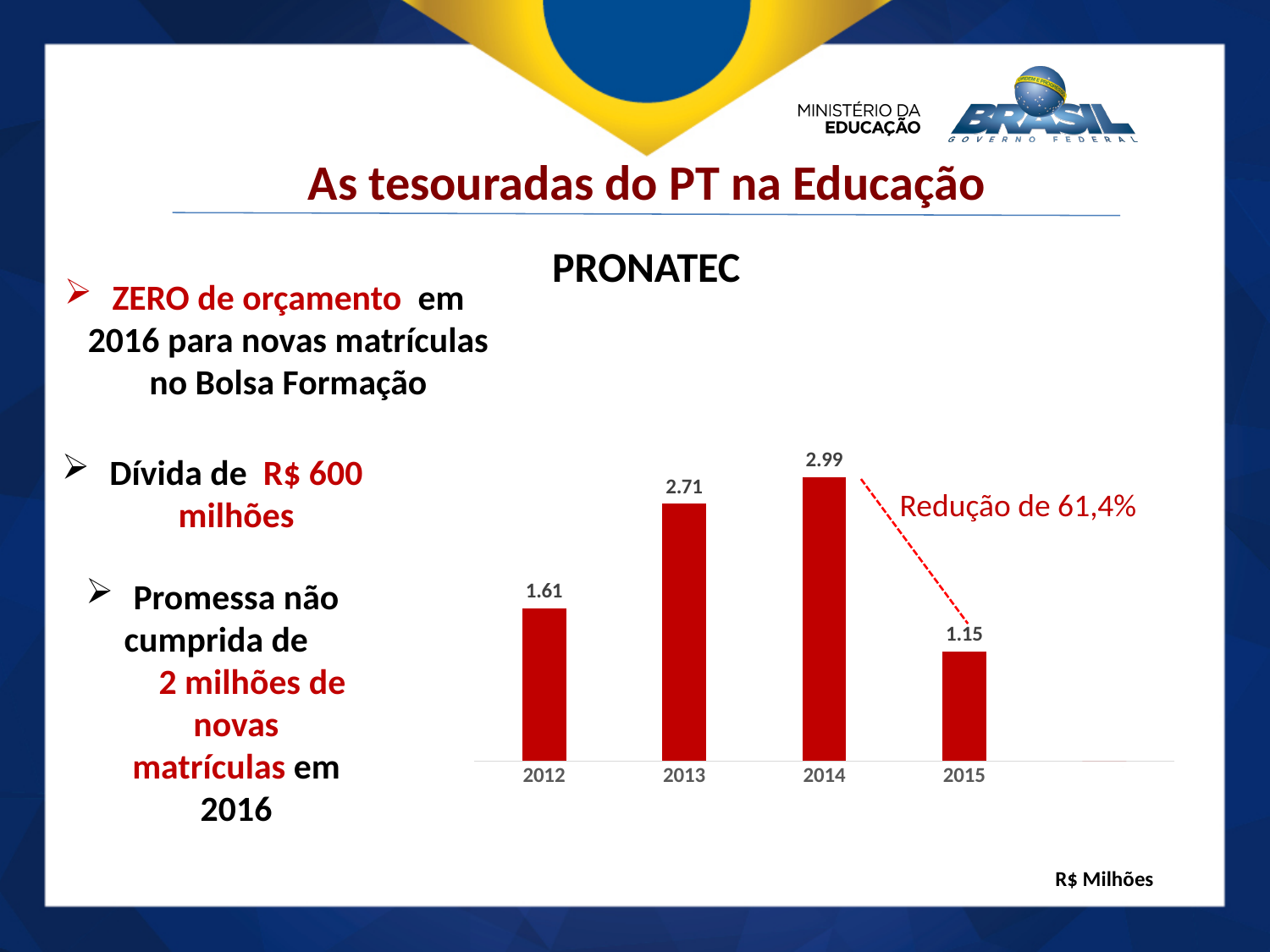
What is the difference between the 2014 and 2015 values in the PRONATEC chart? 1.84 Which is larger in the PRONATEC chart, the value for 2013 or the value for 2015? 2013 What percentage reduction is annotated between 2014 and 2015 in the PRONATEC chart? 61,4% What unit is indicated for the values in the PRONATEC chart? R$ Milhões What kind of chart is the PRONATEC chart? Bar chart How many years are shown in the PRONATEC chart? 4 Which year has the lowest value in the PRONATEC chart? 2015 What is the value for 2015 in the PRONATEC chart? 1.15 What is the value for 2012 in the PRONATEC chart? 1.61 What is the value for 2014 in the PRONATEC chart? 2.99 Which year has the highest value in the PRONATEC chart? 2014 What is the difference between the 2013 and 2012 values in the PRONATEC chart? 1.10